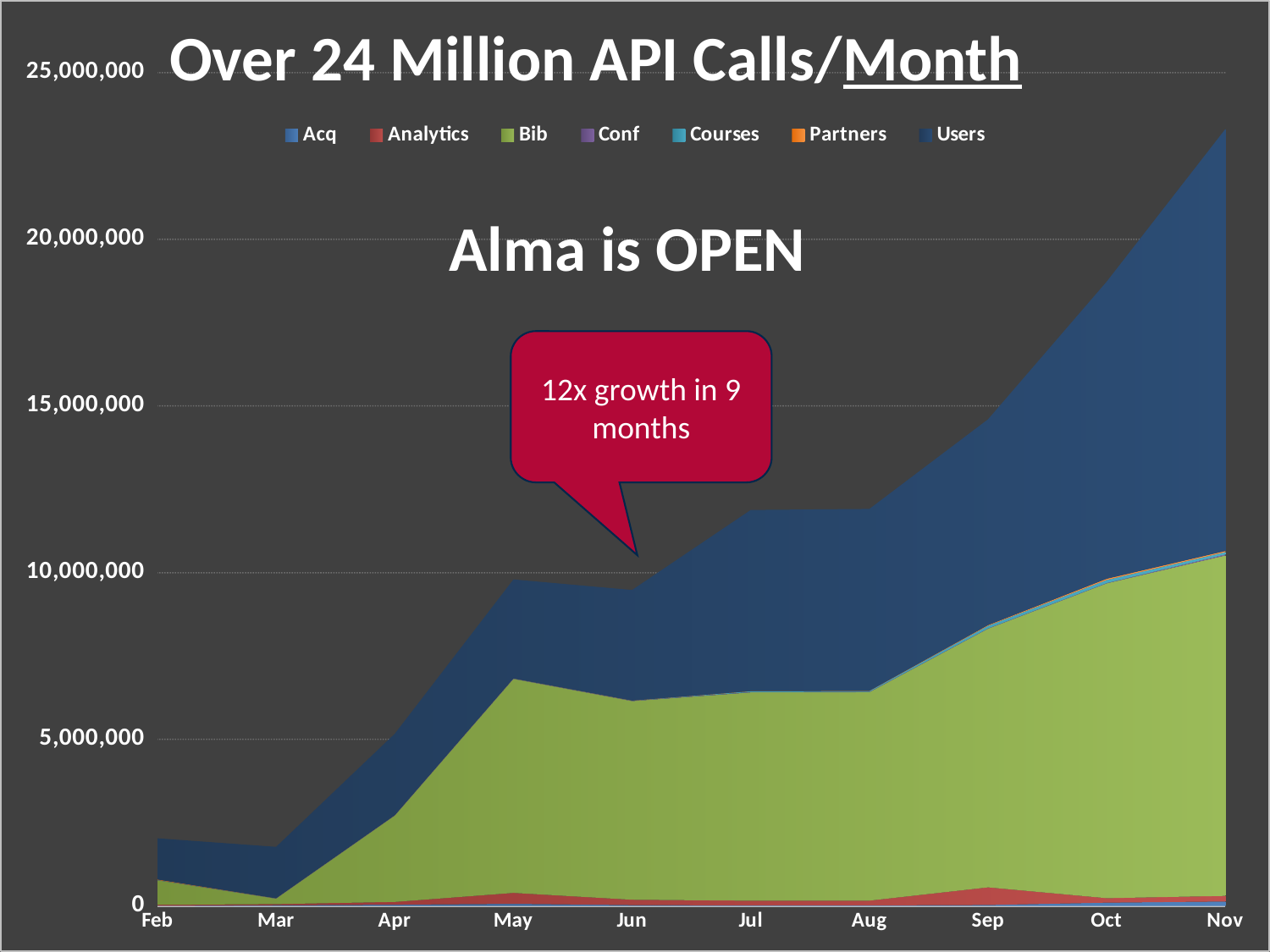
How many series does the legend list? 7 Is the total value for Nov greater or less than 20,000,000? greater How many months are shown along the x axis? 10 What kind of chart is shown on the slide? Stacked area chart Which month has the lowest total API calls? Mar Do the total API calls generally rise or fall from Feb to Nov? rise Which month has the highest total API calls? Nov What does the red callout on the chart say? 12x growth in 9 months Is the total value for Oct greater or less than 15,000,000? greater Is the total value for Feb greater or less than 5,000,000? less What is the title of the chart? Over 24 Million API Calls/Month